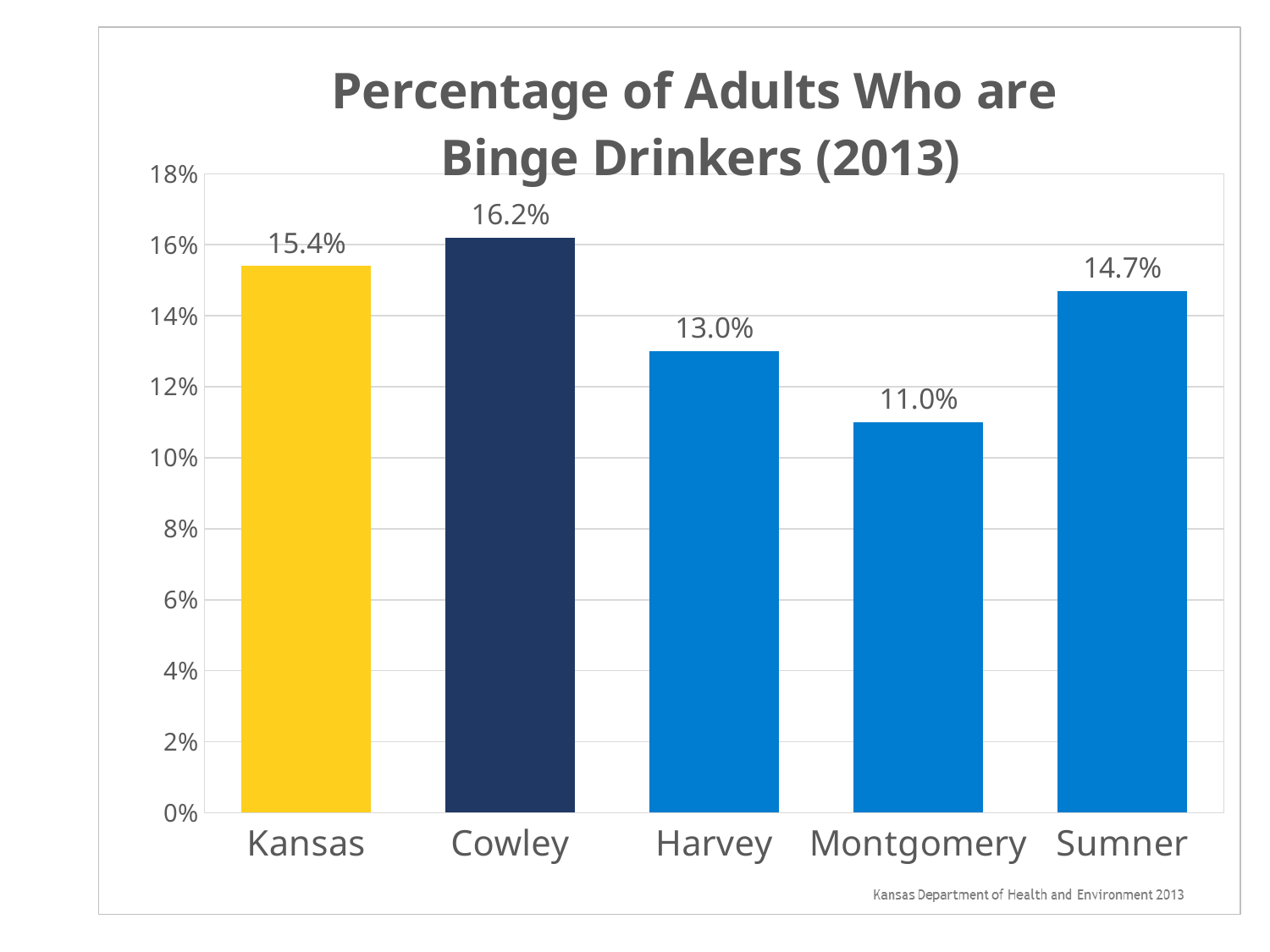
What is the value shown for Cowley? 16.2% What kind of chart is shown on the slide? Bar chart How many categories are shown on the chart? 5 Is the value for Montgomery greater or less than 12%? less Which category has the highest percentage of binge drinkers? Cowley Which has a higher value, Harvey or Sumner? Sumner What is the value shown for Montgomery? 11.0% What is the difference between the values for Kansas and Sumner? 0.7% What is the title of the chart? Percentage of Adults Who are Binge Drinkers (2013) What is the difference between the values for Cowley and Harvey? 3.2% Which category has the lowest percentage of binge drinkers? Montgomery What is the percentage of adults who are binge drinkers in Kansas? 15.4%